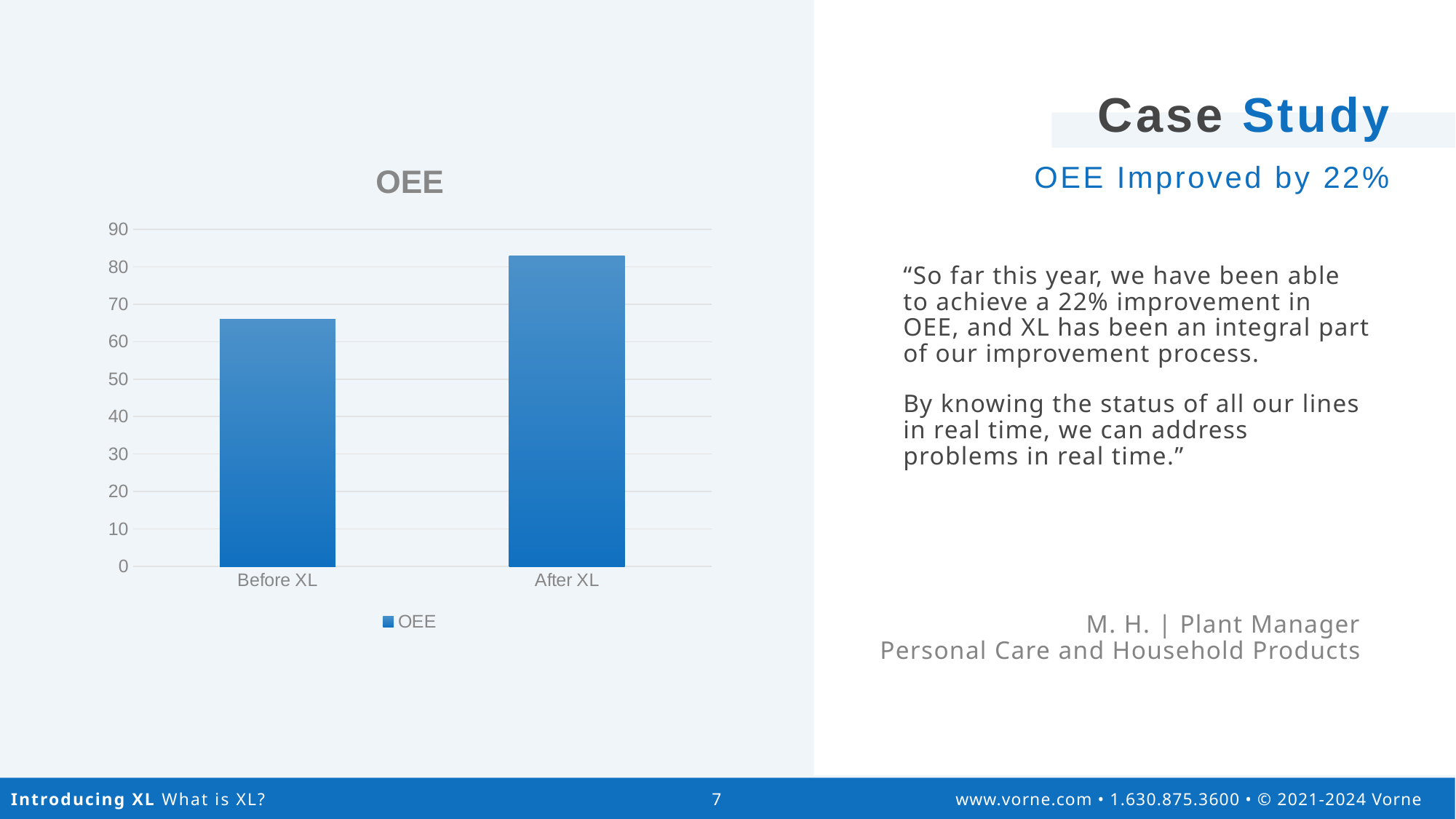
How many series does the chart legend list? 1 What is the title of the chart? OEE Is the OEE value for After XL greater or less than 80? greater Which is larger, the OEE value for Before XL or for After XL? After XL Which category has the highest OEE value? After XL Is the OEE value for Before XL greater or less than 60? greater What type of chart is shown on the slide? bar chart Do the OEE values rise or fall from Before XL to After XL? rise Is the OEE value for Before XL greater or less than 70? less How many categories are shown on the x axis of the chart? 2 What series name appears in the chart legend? OEE Which category has the lowest OEE value? Before XL